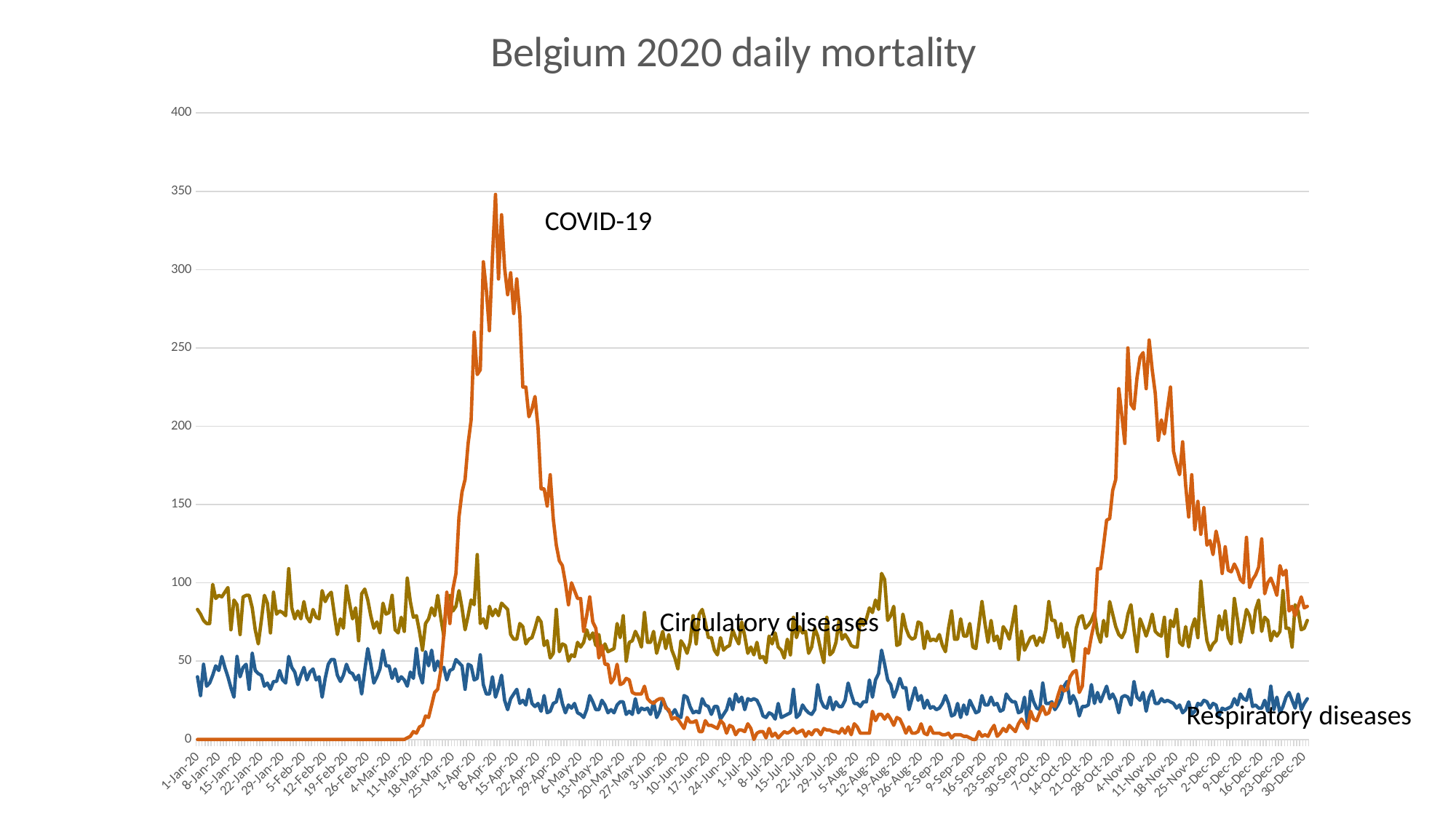
Is the Circulatory diseases value on 1-Jan-20 greater or less than 50? greater Which series reaches the highest value on the chart? COVID-19 Is the Respiratory diseases value on 30-Dec-20 greater or less than 50? less Is the COVID-19 value at its November peak greater or less than 200? greater Does the COVID-19 series rise or fall between 8-Apr-20 and 1-Jul-20? fall How many series are plotted on the chart? 3 Which series has the lowest value on 1-Jan-20? COVID-19 What is the COVID-19 value on 1-Jan-20? 0 What kind of chart is shown on the slide? line chart What is the title of the chart? Belgium 2020 daily mortality Which series has the highest value around 1-Jul-20? Circulatory diseases